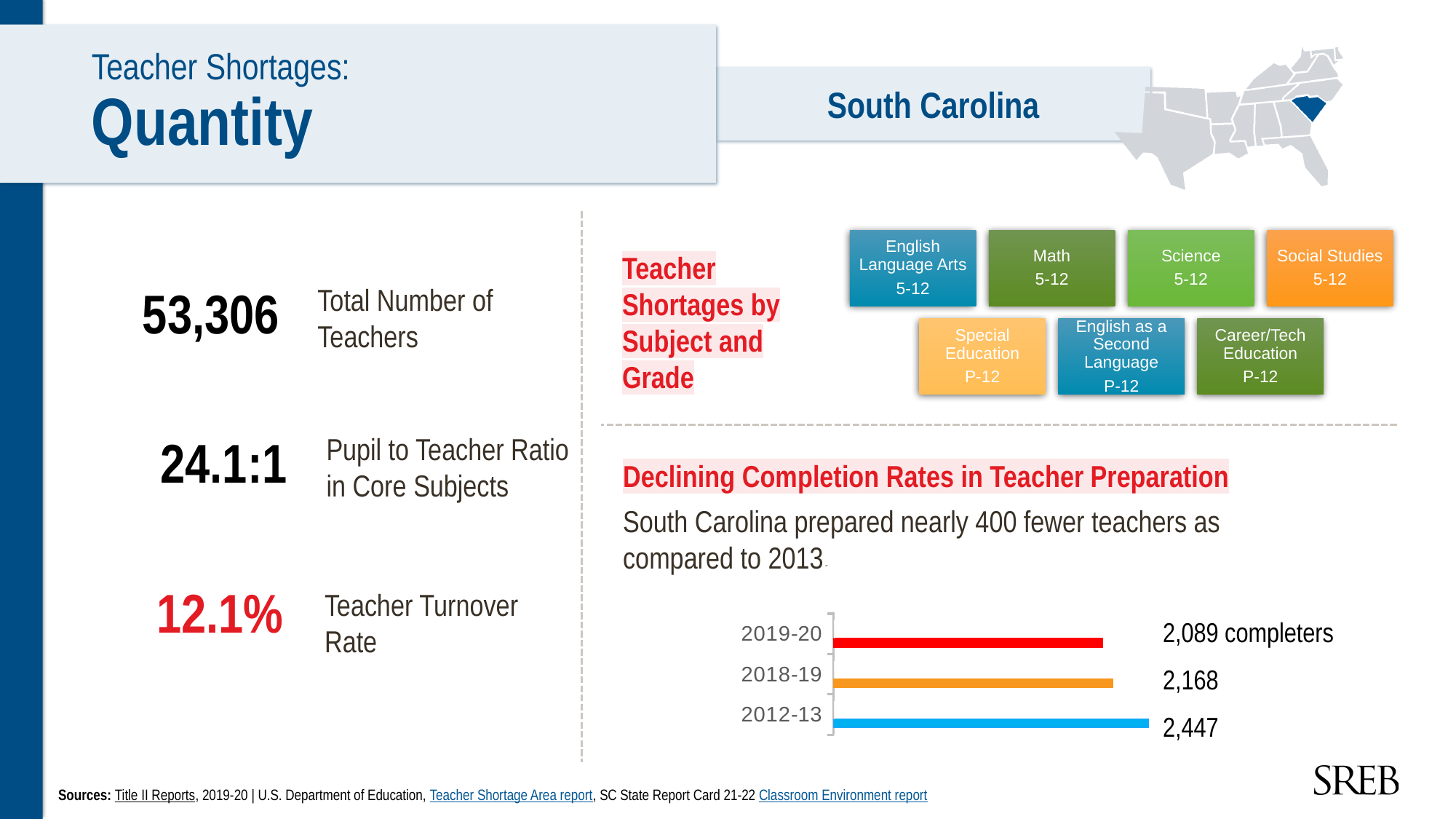
Do the completer values rise or fall from 2012-13 to 2019-20? fall Which year has the highest number of completers in the chart? 2012-13 What colour is the bar for 2019-20 in the completers chart? red What kind of chart is shown under "Declining Completion Rates in Teacher Preparation"? bar chart What is the difference in completers between 2012-13 and 2019-20? 358 Which year has the lowest number of completers in the chart? 2019-20 How many years (bars) are shown in the completers chart? 3 Which has more completers, 2018-19 or 2012-13? 2012-13 How many completers does the chart show for 2019-20? 2,089 What is the value shown for 2018-19 in the completers chart? 2,168 What is the value shown for 2012-13 in the completers chart? 2,447 What is the difference in completers between 2018-19 and 2019-20? 79